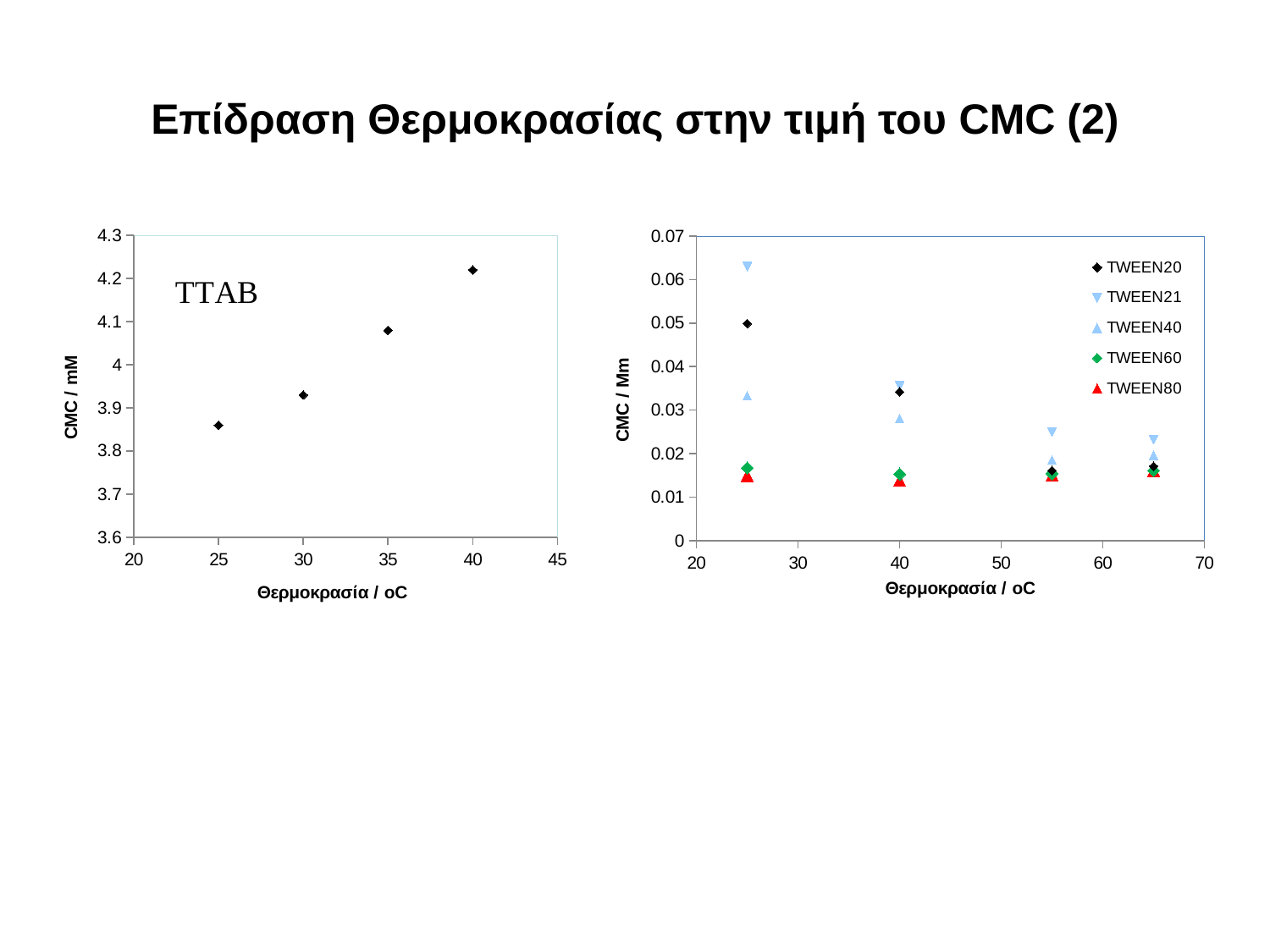
On the right chart, which series has the lowest CMC value at 25 °C? TWEEN80 On the left chart (TTAB), do the CMC values rise or fall as temperature increases? rise On the left chart (TTAB), is the CMC value at 25 °C greater or less than 3.9? less On the left chart (TTAB), is the CMC value at 35 °C greater or less than 4? greater How many data points are plotted on the left chart (TTAB)? 4 How many series does the legend of the right chart list? 5 On the right chart, which series has the highest CMC value at 25 °C? TWEEN21 On the right chart, is the CMC value of TWEEN21 at 25 °C greater or less than 0.06? greater On the right chart, which is larger at 40 °C: the CMC value of TWEEN40 or TWEEN60? TWEEN40 What kind of chart is the left chart (TTAB)? scatter chart On the left chart (TTAB), at which temperature is the CMC value highest? 40 On the right chart, does the CMC value of TWEEN20 rise or fall as temperature increases? fall